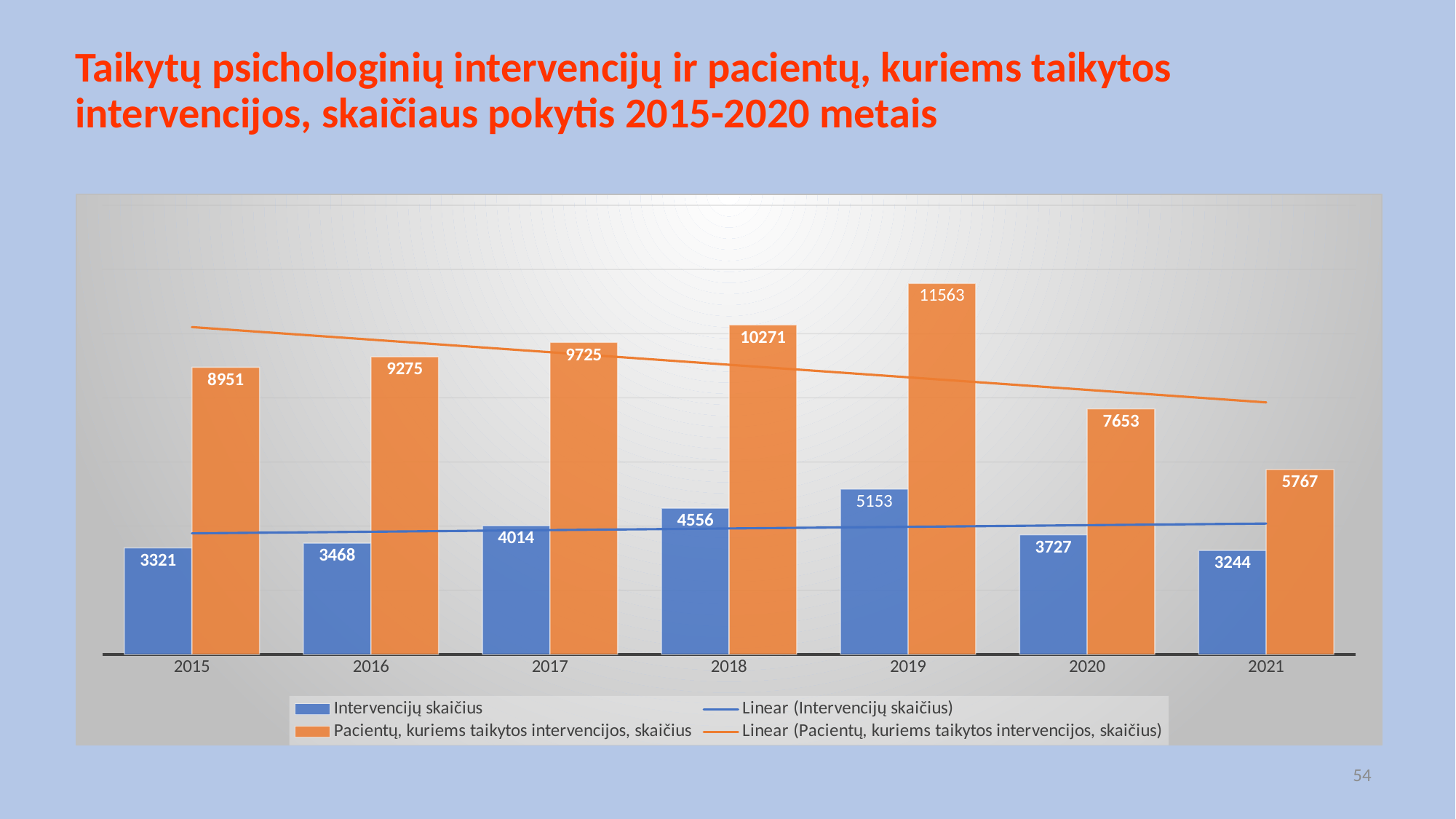
What is the difference between Pacientų, kuriems taikytos intervencijos, skaičius in 2019 and in 2021? 5796 What kind of chart is shown on the slide? bar chart Which colour represents Intervencijų skaičius in the chart? blue Which is larger: Intervencijų skaičius in 2016 or in 2020? 2020 What is the value of Pacientų, kuriems taikytos intervencijos, skaičius for 2020? 7653 In which year is Intervencijų skaičius lowest? 2021 In which year is Pacientų, kuriems taikytos intervencijos, skaičius highest? 2019 What is the difference between Intervencijų skaičius in 2019 and in 2015? 1832 Does Pacientų, kuriems taikytos intervencijos, skaičius rise or fall from 2019 to 2021? fall How many years are shown on the x axis? 7 What is the value of Intervencijų skaičius for 2018? 4556 How many entries does the legend list? 4